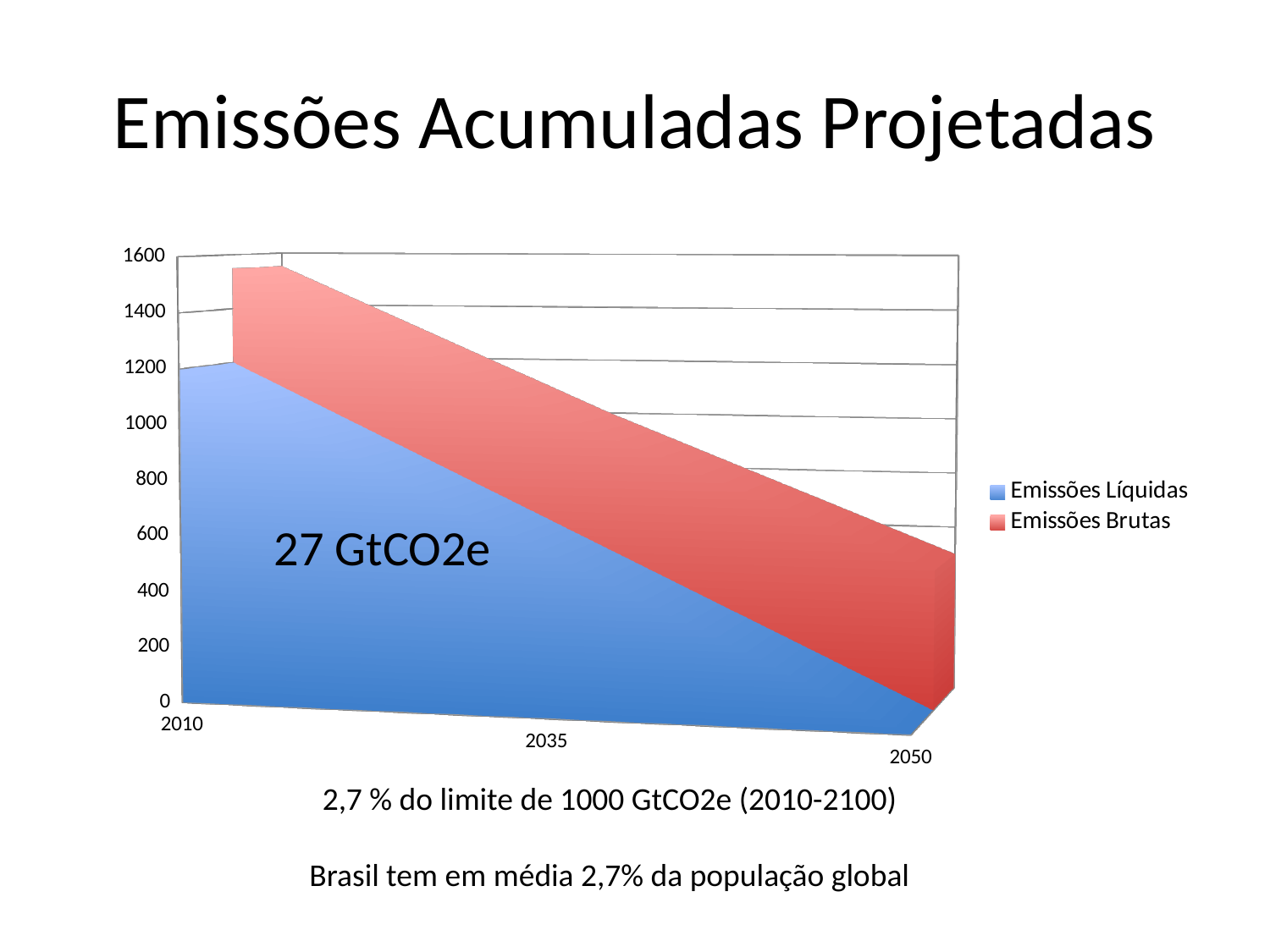
How many years are labelled on the x axis of the chart? 3 Is the value for Emissões Líquidas in 2010 greater or less than 1000? greater In which year is the value for Emissões Líquidas lowest? 2050 In which year is the value for Emissões Líquidas highest? 2010 Is the value for Emissões Líquidas in 2050 greater or less than 200? less Do the values for Emissões Líquidas rise or fall from 2010 to 2050? Fall Which series is shown in blue in the chart? Emissões Líquidas What kind of chart is shown on the slide? Area chart Do the values for Emissões Brutas rise or fall from 2010 to 2050? Fall In 2010, which series has the larger value, Emissões Brutas or Emissões Líquidas? Emissões Brutas What is the title of the slide containing the chart? Emissões Acumuladas Projetadas How many series does the legend list? 2